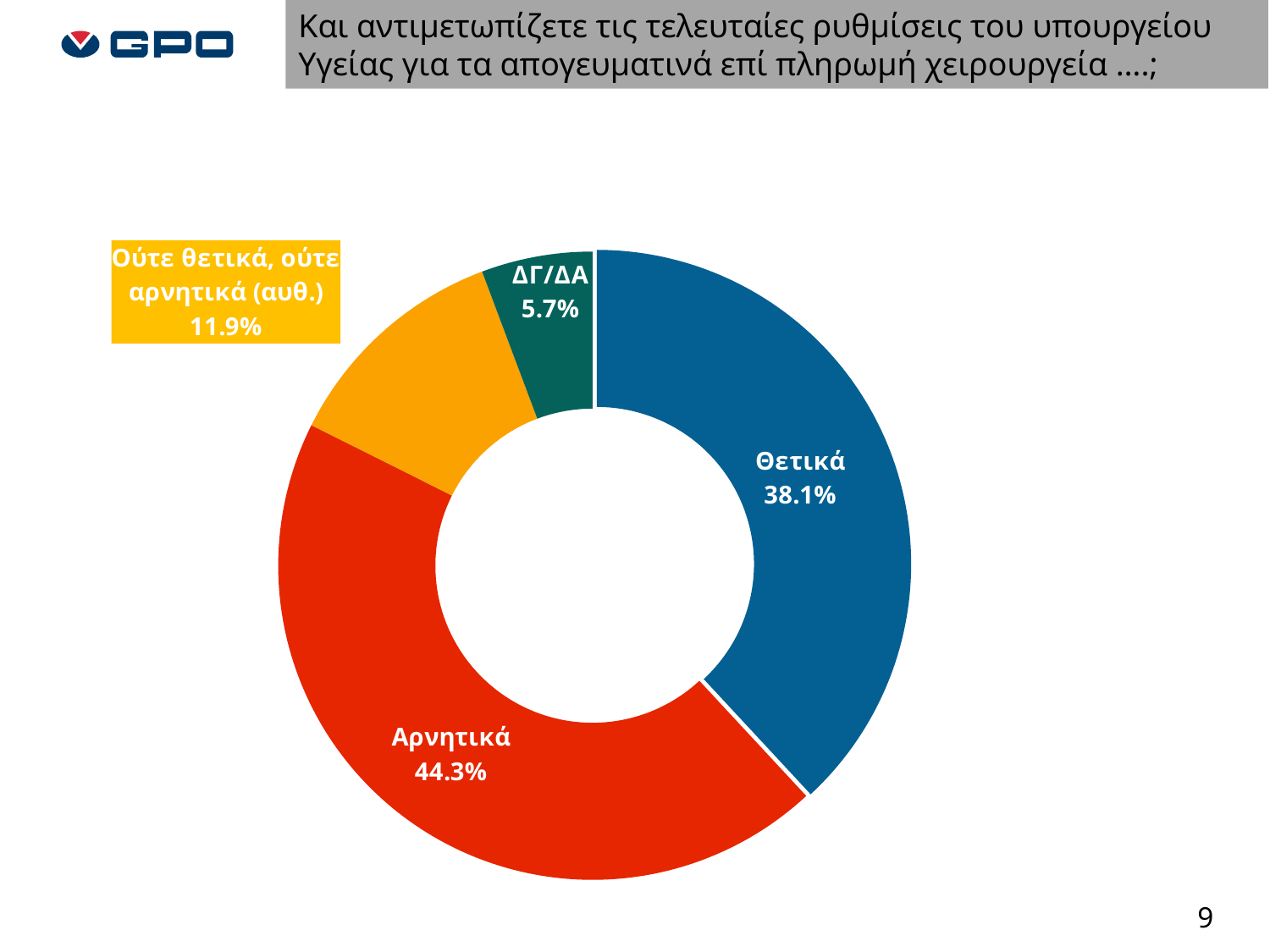
What percentage of respondents answered Αρνητικά? 44.3% What is the combined share of Θετικά and Αρνητικά? 82.4% What colour is the Αρνητικά segment? Red What is the difference in percentage points between Αρνητικά and Θετικά? 6.2 What is the value shown for Ούτε θετικά, ούτε αρνητικά (αυθ.)? 11.9% Which category has the smallest share of the chart? ΔΓ/ΔΑ Which is larger, Θετικά or Ούτε θετικά, ούτε αρνητικά (αυθ.)? Θετικά Which category has the largest share of the chart? Αρνητικά How many categories are shown in the chart? 4 What is the value shown for ΔΓ/ΔΑ? 5.7% What percentage of respondents answered Θετικά? 38.1% What kind of chart is shown on the slide? Doughnut (pie) chart